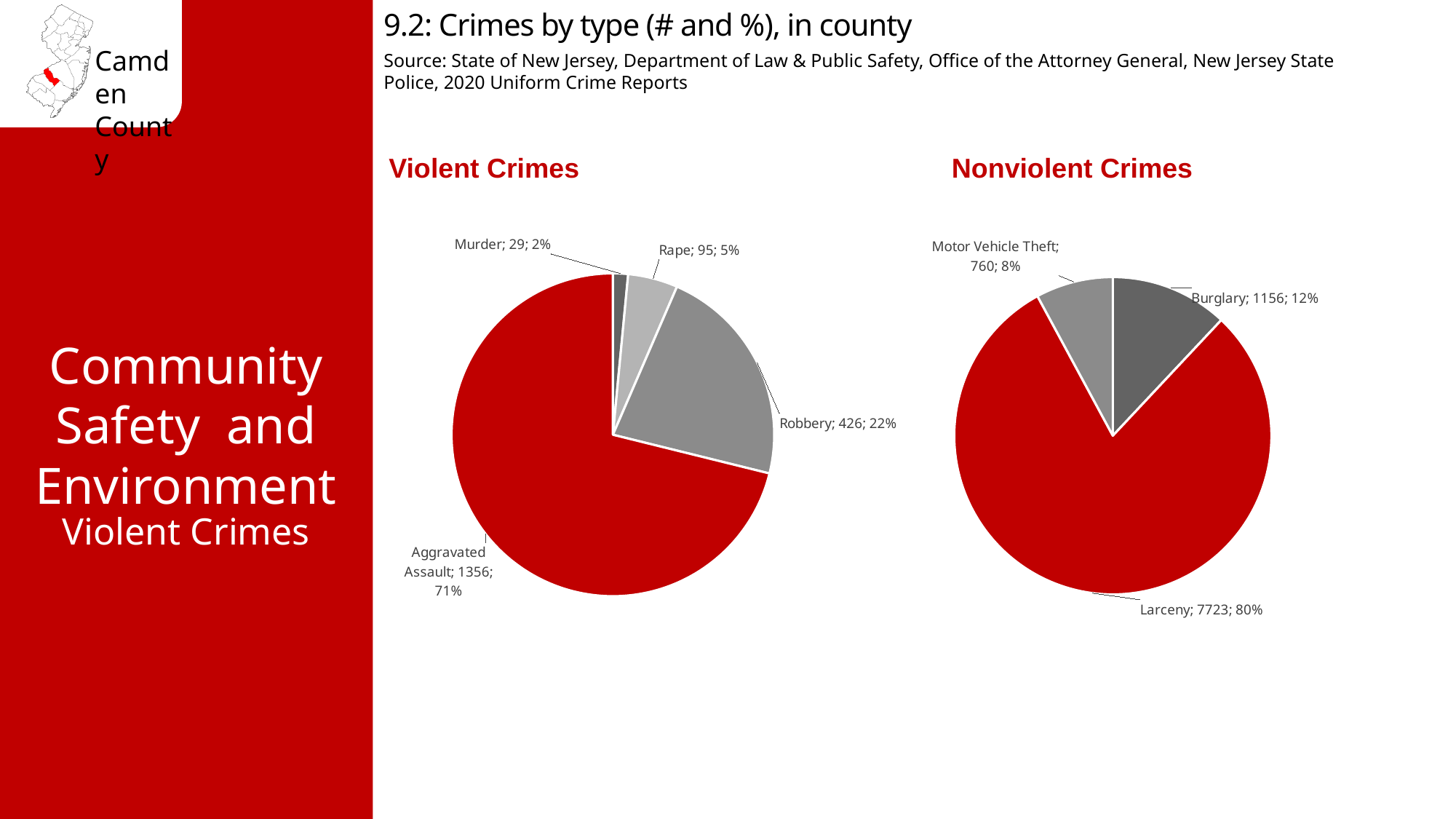
In the Nonviolent Crimes chart, what share of the pie is Burglary? 12% What kind of chart is used for the Nonviolent Crimes data? Pie chart In the Nonviolent Crimes chart, which category has the smallest slice? Motor Vehicle Theft In the Violent Crimes chart, which category has the largest slice? Aggravated Assault In the Violent Crimes chart, how many categories are shown? 4 In the Violent Crimes chart, which category has the smallest slice? Murder In the Nonviolent Crimes chart, how many larcenies are shown? 7723 In the Violent Crimes chart, what is the difference between the number of robberies and the number of rapes? 331 In the Violent Crimes chart, how many aggravated assaults are shown? 1356 In the Violent Crimes chart, what share of the pie is Robbery? 22% In the Nonviolent Crimes chart, which is larger, Burglary or Motor Vehicle Theft? Burglary In the Nonviolent Crimes chart, what is the difference between the number of burglaries and the number of motor vehicle thefts? 396